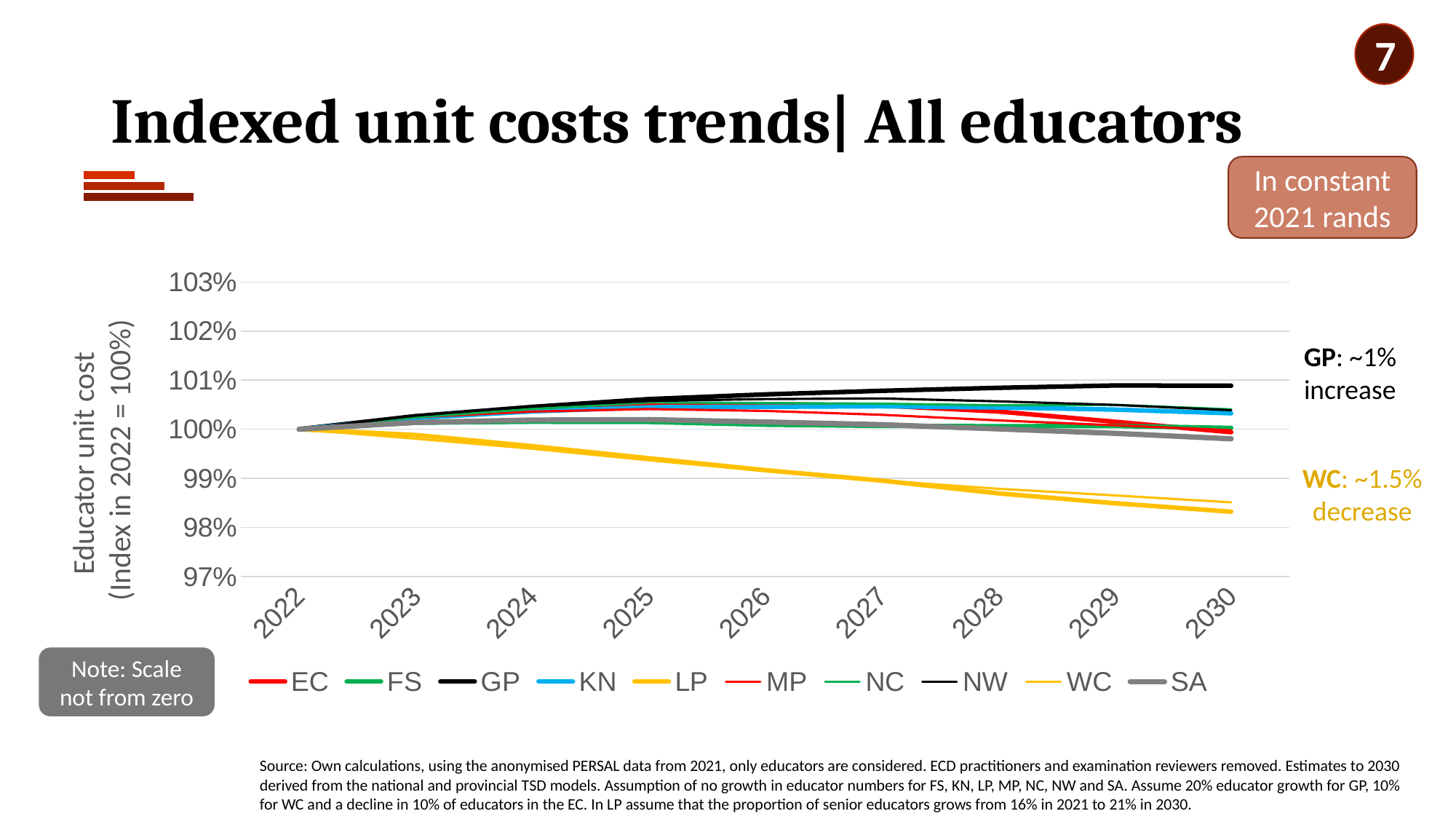
What kind of chart is shown on the slide? Line chart Which is larger in 2030, the value for GP or the value for WC? GP Is the value for LP in 2030 greater or less than 99%? less How many series does the legend list? 10 Does the GP line rise or fall from 2022 to 2030? Rises According to the annotation on the chart, what approximate change does WC show? ~1.5% decrease Does the LP line rise or fall from 2022 to 2030? Falls How many years are shown along the x axis? 9 What is the indexed unit cost value for all series in 2022? 100% Is the value for GP in 2030 greater or less than 100%? greater Which series has the highest value in 2030? GP What is the title of the chart on the slide? Indexed unit costs trends| All educators